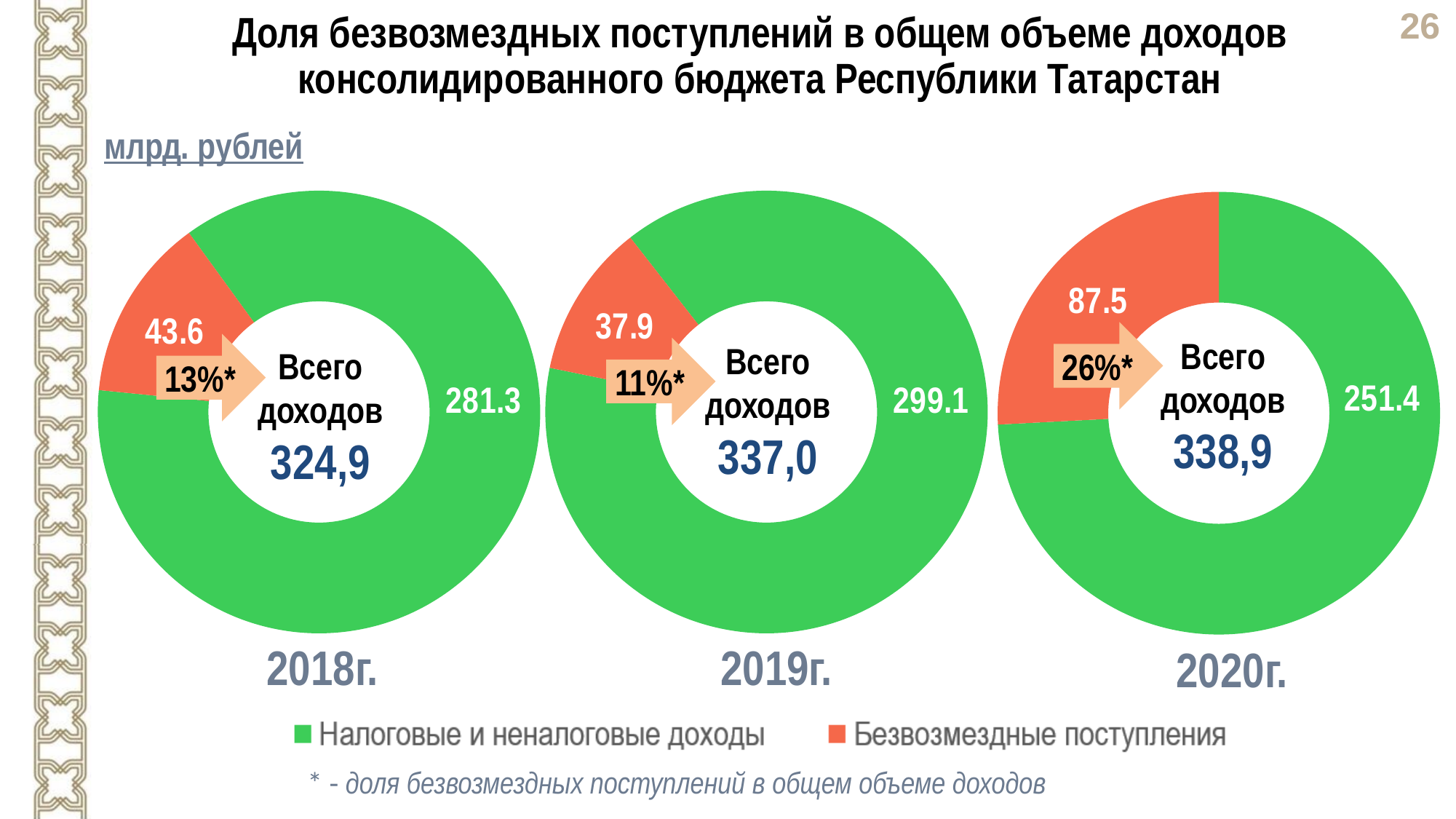
In the 2019г. chart, what share of total income do Безвозмездные поступления make up, as printed on the slide? 11% Across the three charts, which year has the highest value for Безвозмездные поступления? 2020г. What is the difference between the Безвозмездные поступления values in the 2020г. chart and the 2018г. chart? 43.9 In the 2020г. chart, what share of total income do Безвозмездные поступления make up, as printed on the slide? 26% What kind of chart is used on this slide? Donut (pie) chart In the 2019г. chart, what is the value for Налоговые и неналоговые доходы? 299.1 How many series does the legend list? 2 In the 2020г. chart, what is the value for Безвозмездные поступления? 87.5 Which is larger: Налоговые и неналоговые доходы in the 2018г. chart or in the 2019г. chart? 2019г. In the 2020г. chart, what total (Всего доходов) is shown in the centre? 338,9 In the 2018г. chart, what is the value for Безвозмездные поступления? 43.6 Across the three charts, which year has the lowest value for Налоговые и неналоговые доходы? 2020г.